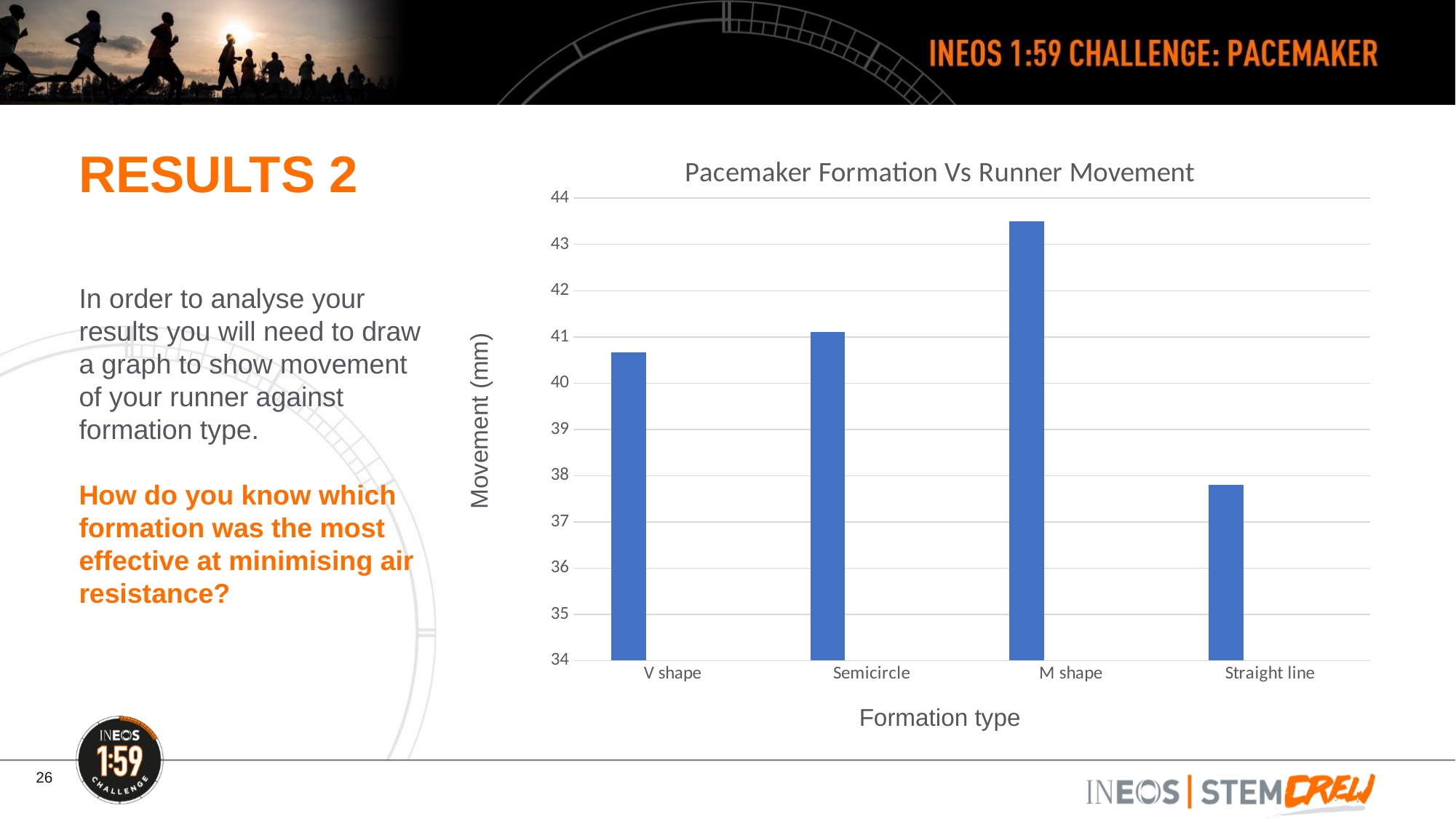
What is the title of the chart? Pacemaker Formation Vs Runner Movement Which formation type has the highest runner movement? M shape How many formation types are plotted on the chart? 4 Is the value for M shape greater or less than 43? greater Is the value for V shape greater or less than 41? less Is the value for Straight line greater or less than 38? less What kind of chart is shown on the slide? bar chart Which has a larger movement value, Semicircle or Straight line? Semicircle Which has a larger movement value, V shape or M shape? M shape What is the label of the vertical axis? Movement (mm) Which formation type has the lowest runner movement? Straight line